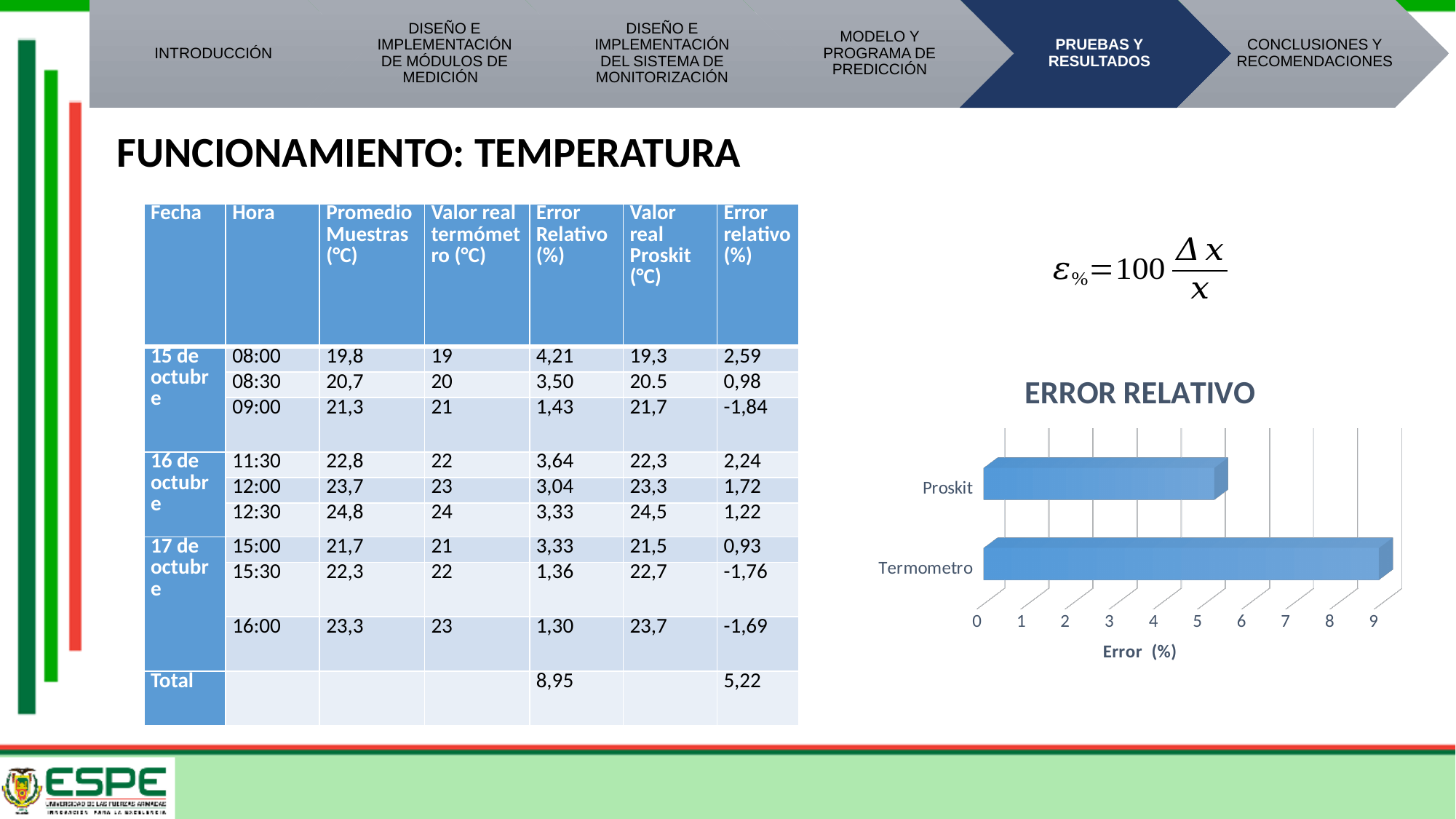
In the ERROR RELATIVO chart, is the value for Termometro greater or less than 8? greater What kind of chart is the ERROR RELATIVO chart? bar chart In the ERROR RELATIVO chart, which is larger, the value for Proskit or the value for Termometro? Termometro In the ERROR RELATIVO chart, is the value for Proskit greater or less than 4? greater How many categories are shown in the ERROR RELATIVO chart? 2 What is the label of the horizontal axis in the ERROR RELATIVO chart? Error (%) Which category has the highest value in the ERROR RELATIVO chart? Termometro In the ERROR RELATIVO chart, is the value for Proskit greater or less than 6? less What is the title of the chart on the slide? ERROR RELATIVO Which category has the lowest value in the ERROR RELATIVO chart? Proskit